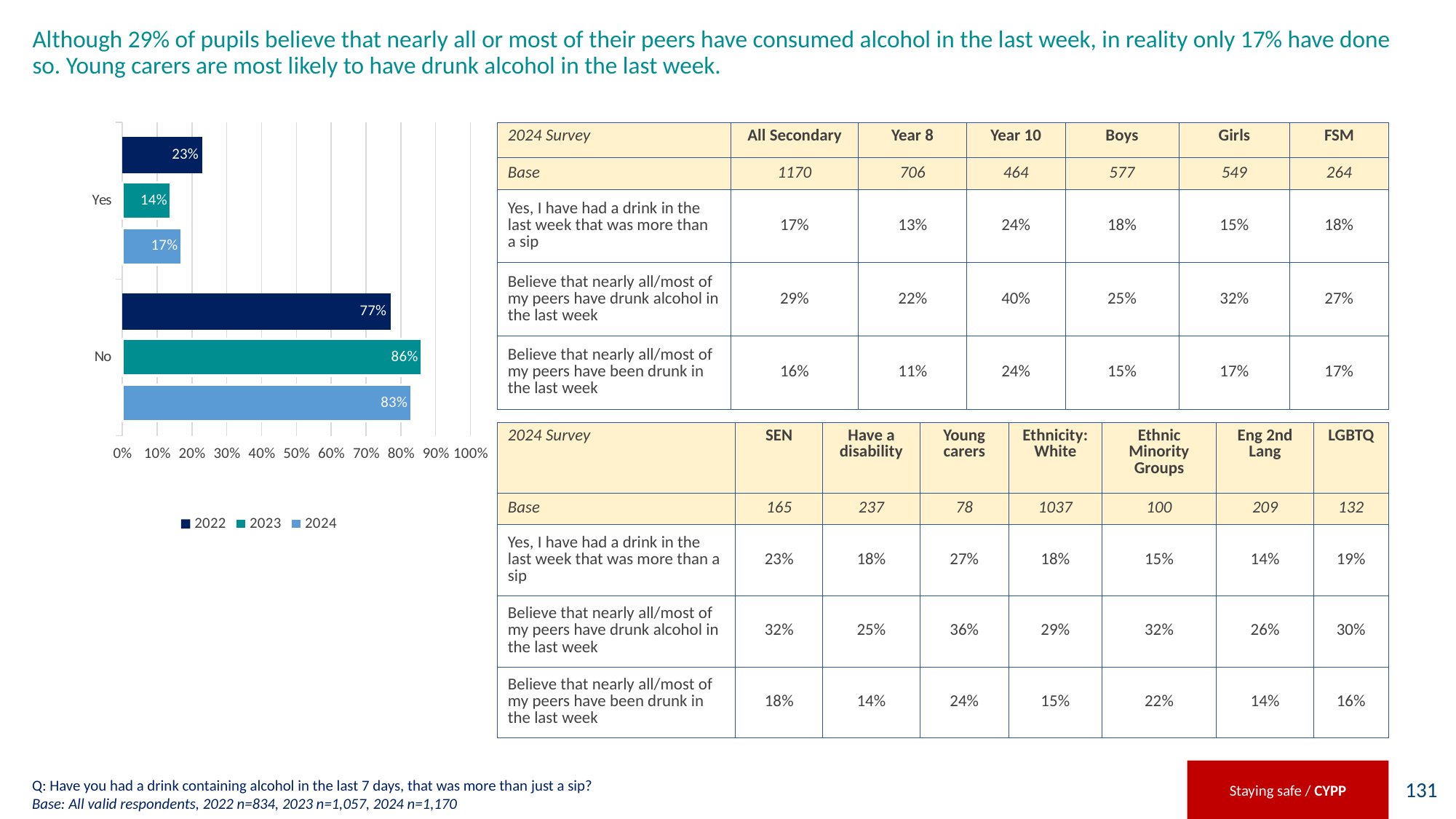
What is the value for 'Yes' in 2024 on the bar chart? 17% Which year has the highest value for 'Yes' on the bar chart? 2022 What is the value for 'No' in 2024 on the bar chart? 83% Which year has the lowest value for 'Yes' on the bar chart? 2023 What is the value for 'Yes' in 2022 on the bar chart? 23% What is the difference between the 'No' values for 2023 and 2022 on the bar chart? 9% Is the value for 'No' in 2022 greater or less than 70%? greater How many series does the legend of the bar chart list? 3 What is the value for 'No' in 2023 on the bar chart? 86% How many categories are shown on the bar chart's vertical axis? 2 What kind of chart is shown on the left of the slide? Bar chart Which is larger on the bar chart: the 'Yes' value for 2024 or the 'Yes' value for 2023? 2024